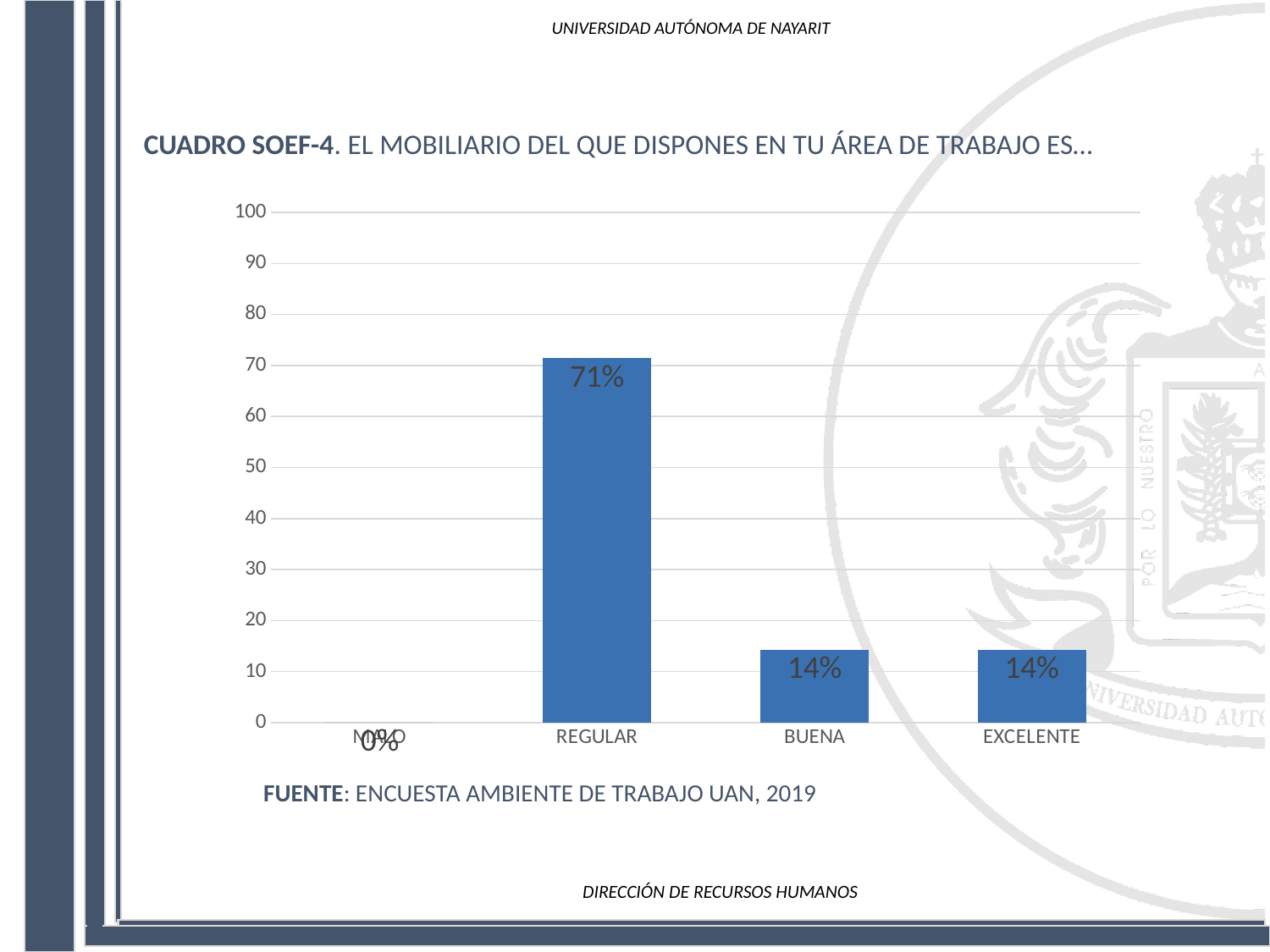
Which category has the highest value? REGULAR What source is cited below the chart? ENCUESTA AMBIENTE DE TRABAJO UAN, 2019 What is the difference between the values for REGULAR and BUENA? 57% How many categories are shown on the x axis? 4 What is the value for BUENA? 14% What is the value for EXCELENTE? 14% What is the value for REGULAR? 71% What kind of chart is shown on the slide? bar chart Is the value for BUENA greater or less than 20? less Which is larger, the value for REGULAR or the value for EXCELENTE? REGULAR What is the value shown for the first (leftmost) category? 0% Is the value for REGULAR greater or less than 50? greater